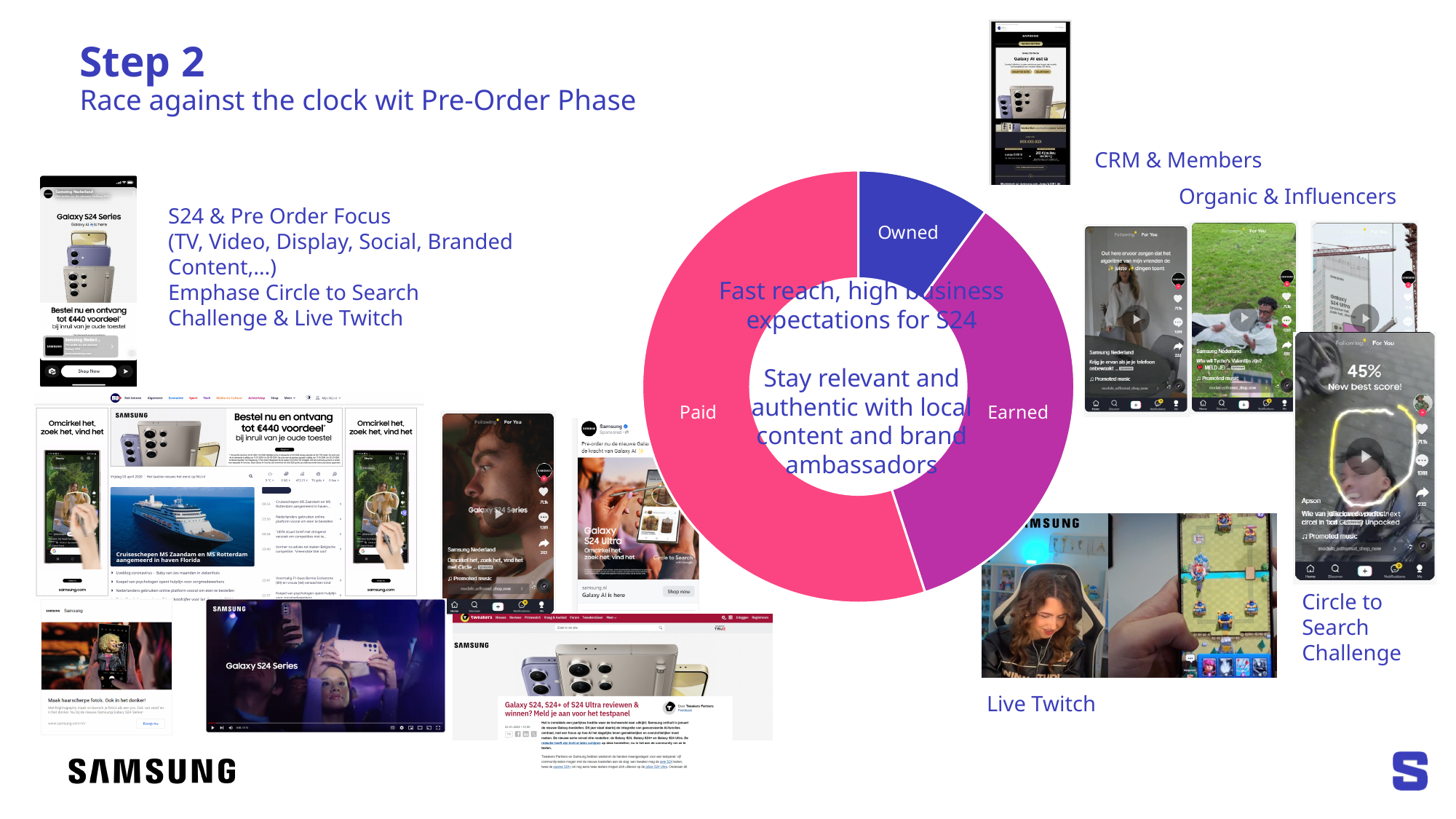
What colour is the Paid segment of the donut chart? Pink Which segment is larger in the donut chart, Earned or Owned? Earned Which segment of the donut chart is the smallest? Owned Which segment is larger in the donut chart, Paid or Earned? Paid What kind of chart is shown in the centre of the slide? Donut (pie) chart What are the labels of the three segments in the donut chart? Paid, Owned, Earned Which segment of the donut chart is the largest? Paid How many segments does the donut chart have? 3 Which segment is smaller in the donut chart, Owned or Paid? Owned